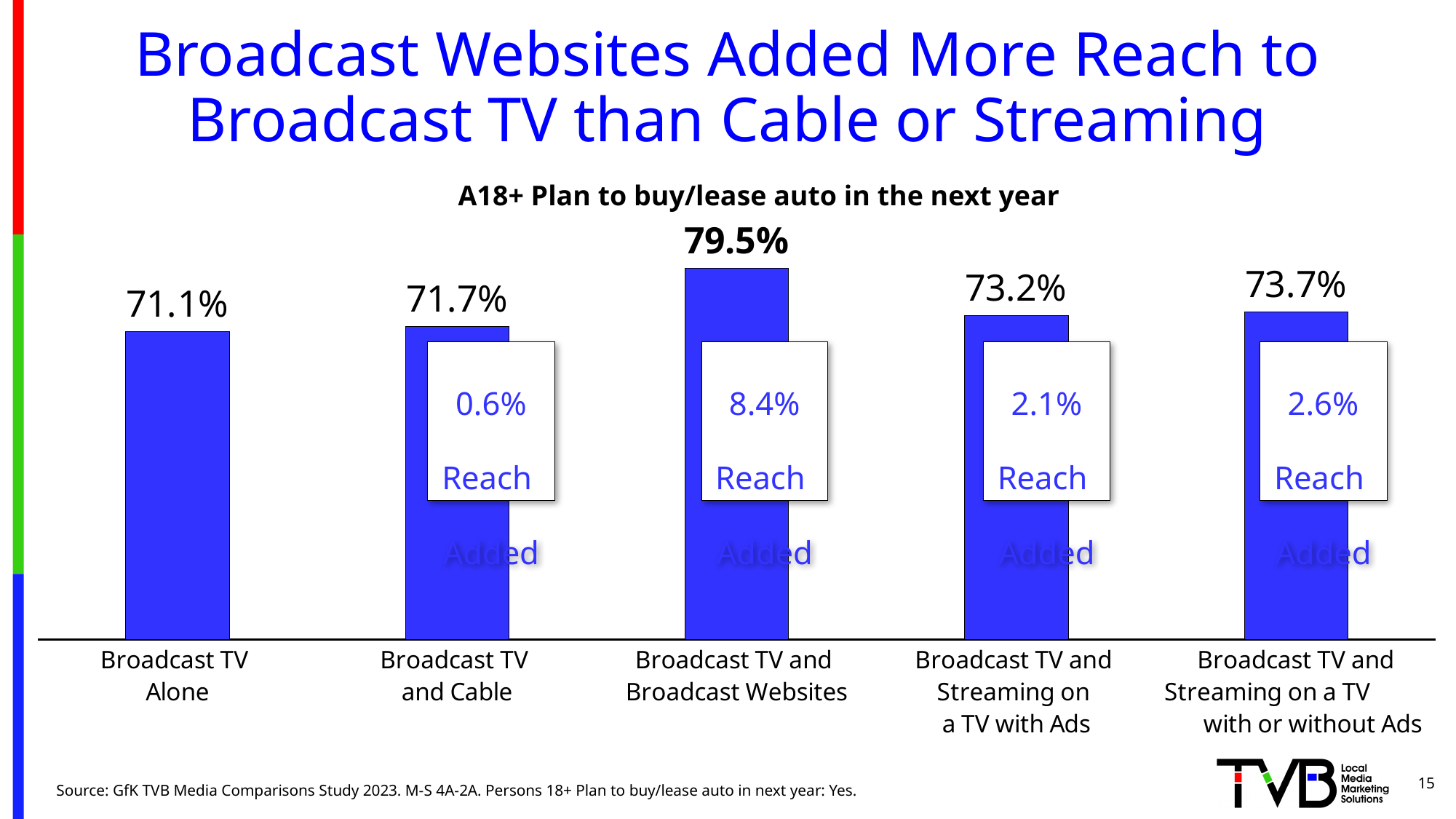
Which is larger: Broadcast TV and Streaming on a TV with or without Ads, or Broadcast TV and Cable? Broadcast TV and Streaming on a TV with or without Ads What is the value for Broadcast TV and Broadcast Websites? 79.5% How many categories are shown in the chart? 5 What is the value for Broadcast TV and Streaming on a TV with Ads? 73.2% What is the difference between Broadcast TV and Broadcast Websites and Broadcast TV Alone? 8.4% How much reach is added by Broadcast TV and Streaming on a TV with or without Ads, according to the callout box? 2.6% What is the chart's title? A18+ Plan to buy/lease auto in the next year What is the value for Broadcast TV Alone? 71.1% Which category has the highest value? Broadcast TV and Broadcast Websites What is the value for Broadcast TV and Cable? 71.7% Which category has the lowest value? Broadcast TV Alone What kind of chart is shown on the slide? Bar chart